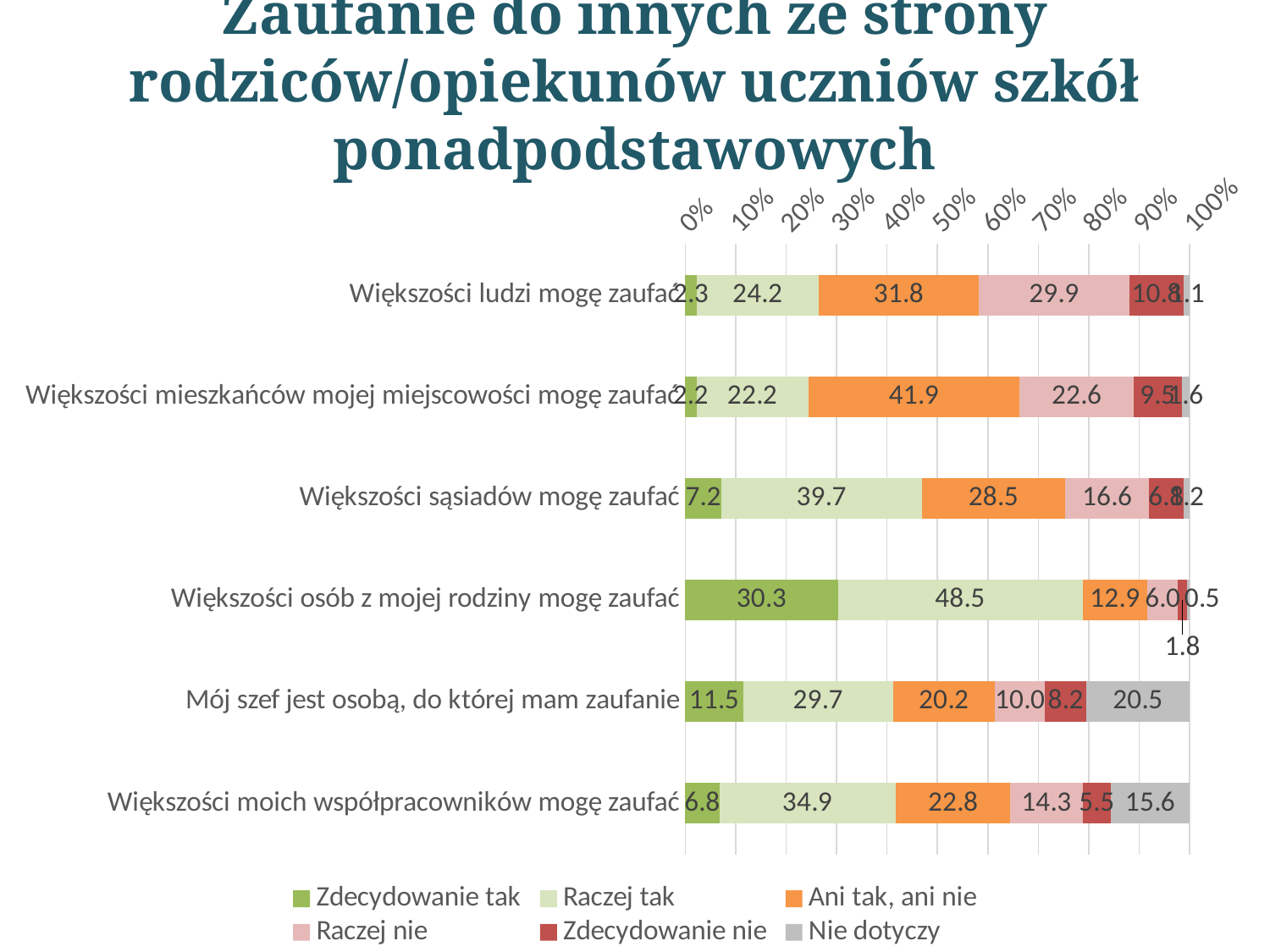
What is the 'Raczej tak' value for 'Większości sąsiadów mogę zaufać'? 39.7 What is the 'Zdecydowanie tak' value for 'Większości osób z mojej rodziny mogę zaufać'? 30.3 Which statement has the highest 'Zdecydowanie tak' value? Większości osób z mojej rodziny mogę zaufać What is the 'Ani tak, ani nie' value for 'Większości mieszkańców mojej miejscowości mogę zaufać'? 41.9 Which statement has the highest 'Ani tak, ani nie' value? Większości mieszkańców mojej miejscowości mogę zaufać How many categories (statements) are plotted on the chart? 6 Which is larger: the 'Raczej nie' value for 'Większości ludzi mogę zaufać' or for 'Większości sąsiadów mogę zaufać'? Większości ludzi mogę zaufać What kind of chart is shown on the slide? stacked bar chart What is the 'Nie dotyczy' value for 'Mój szef jest osobą, do której mam zaufanie'? 20.5 Which legend entry is shown in grey? Nie dotyczy How many series does the legend list? 6 What is the difference between the 'Raczej tak' values for 'Większości osób z mojej rodziny mogę zaufać' and 'Większości moich współpracowników mogę zaufać'? 13.6